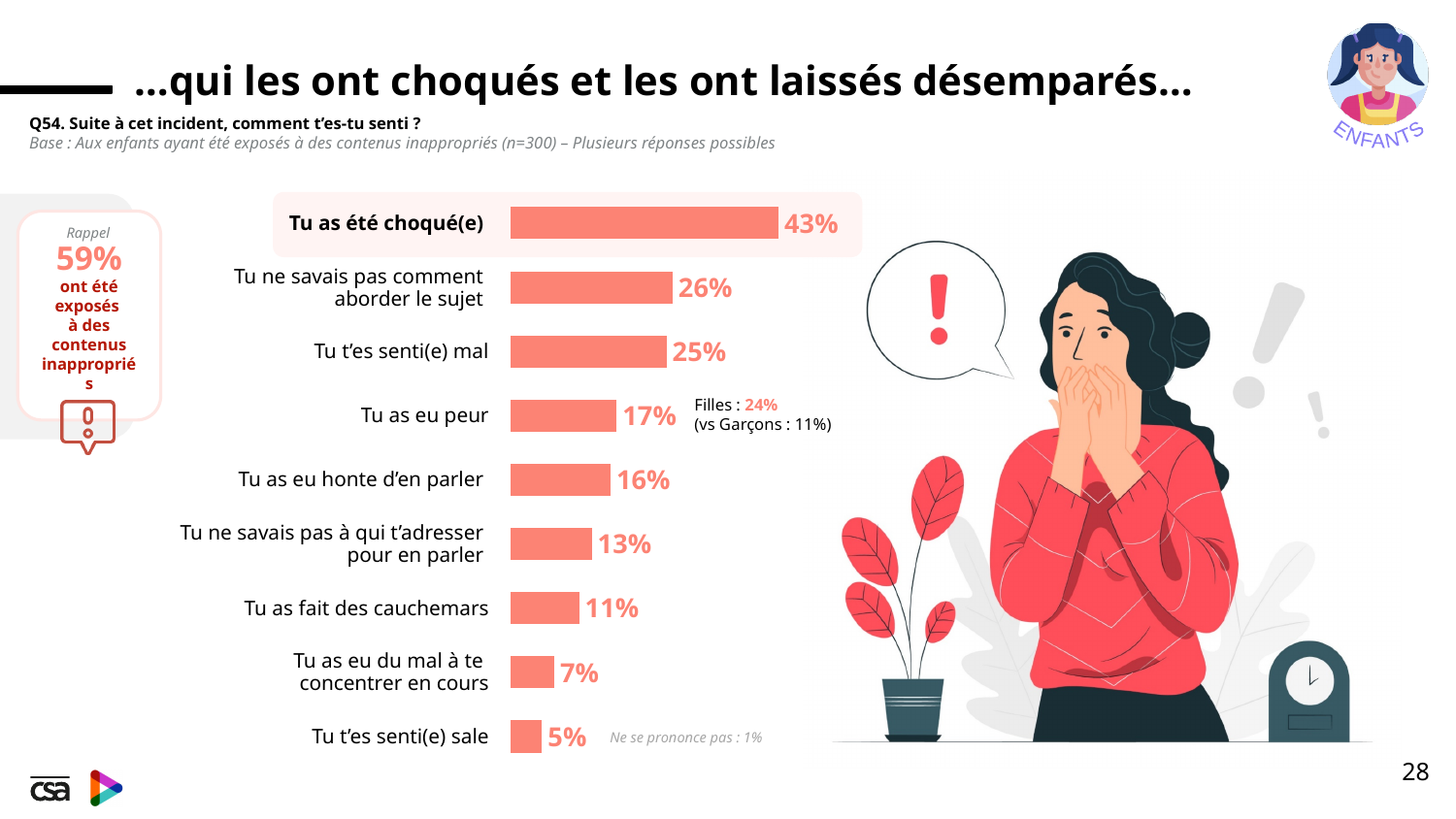
What is the value for "Tu as eu peur"? 17% What percentage of boys answered "Tu as eu peur", according to the annotation? 11% How many response categories are shown in the bar chart? 9 What percentage of girls answered "Tu as eu peur", according to the annotation? 24% What is the value for "Tu as eu du mal à te concentrer en cours"? 7% What is the value for "Tu as fait des cauchemars"? 11% Which response has the lowest percentage? Tu t'es senti(e) sale Which is larger: "Tu as eu honte d'en parler" or "Tu ne savais pas à qui t'adresser pour en parler"? Tu as eu honte d'en parler What type of chart is used on this slide? Bar chart Which response has the highest percentage? Tu as été choqué(e) What is the difference between "Tu as été choqué(e)" and "Tu ne savais pas comment aborder le sujet"? 17 percentage points What percentage of children answered "Tu as été choqué(e)"? 43%